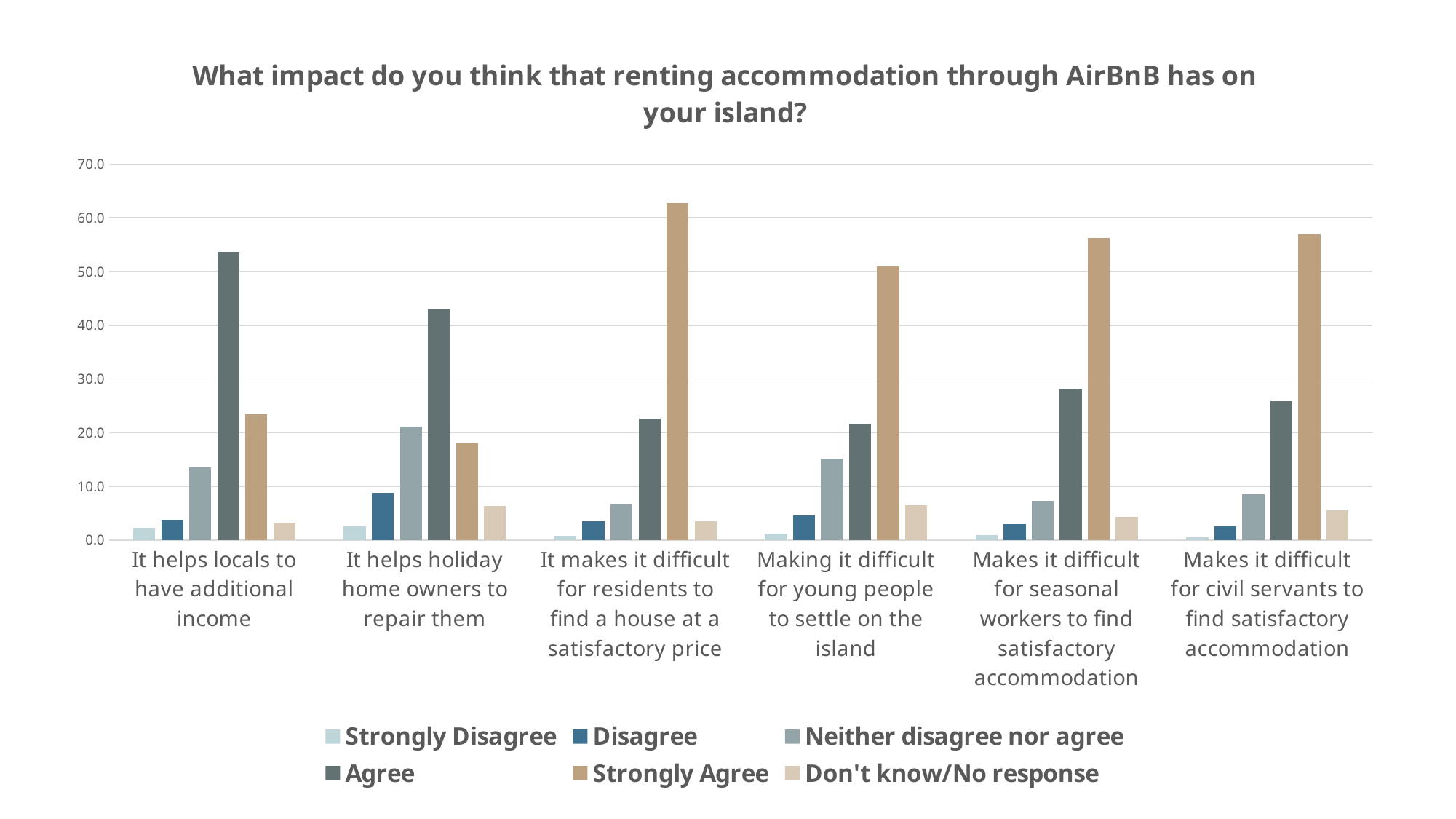
Which statement has the highest Strongly Agree value? It makes it difficult for residents to find a house at a satisfactory price For 'It helps holiday home owners to repair them', which is larger: Agree or Strongly Agree? Agree Is the Strongly Agree value for 'Making it difficult for young people to settle on the island' greater or less than 40.0? greater How many statement categories are shown along the x axis? 6 Which statement has the lowest Strongly Agree value? It helps holiday home owners to repair them Is the Agree value for 'It helps locals to have additional income' greater or less than 50.0? greater Is the Agree value for 'Makes it difficult for seasonal workers to find satisfactory accommodation' greater or less than 20.0? greater How many series does the legend list? 6 What kind of chart is shown on the slide? Bar chart What is the title of the chart? What impact do you think that renting accommodation through AirBnB has on your island? Which series has the highest value for 'It helps locals to have additional income'? Agree